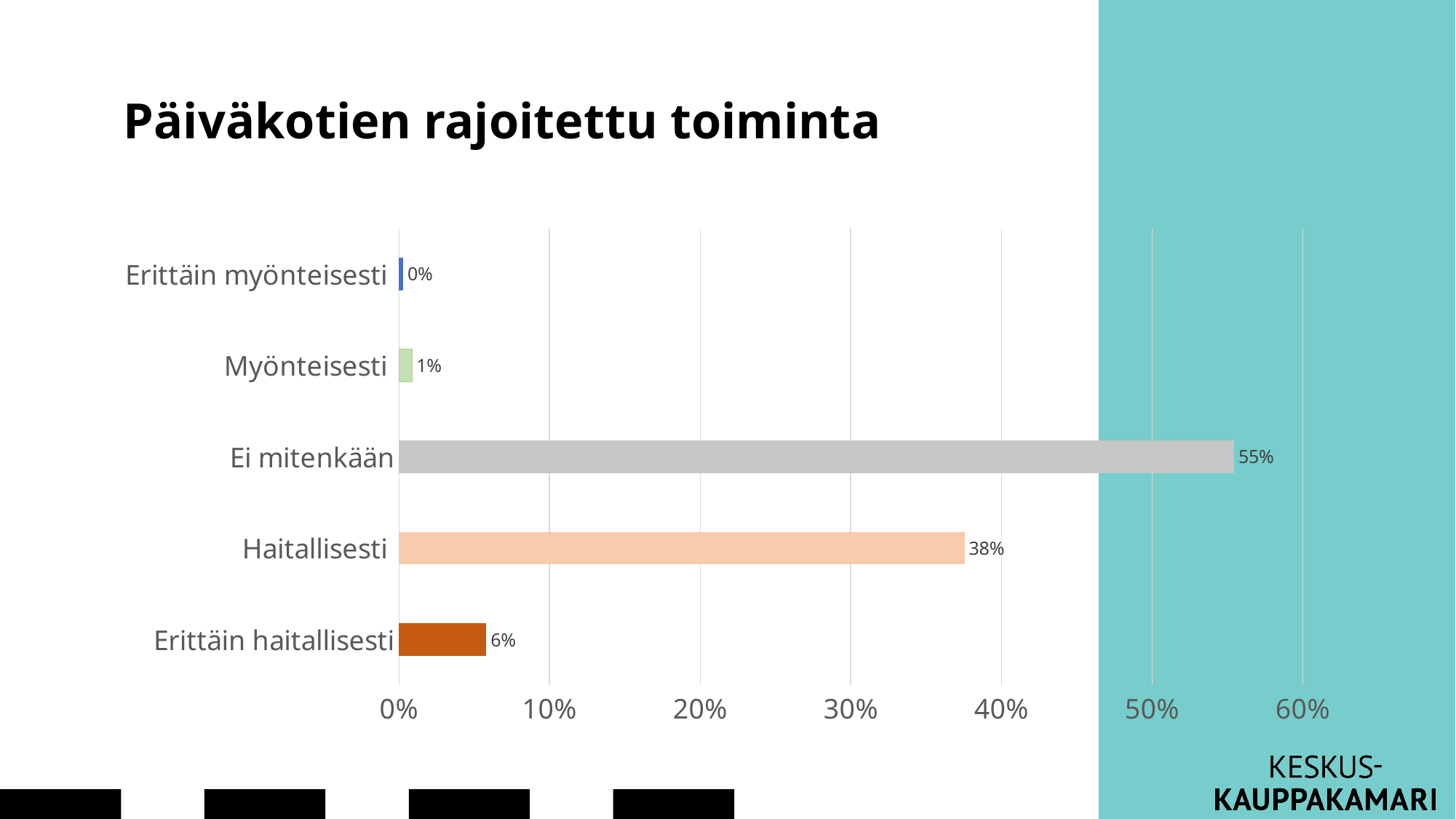
What is the value for Erittäin haitallisesti? 6% What kind of chart is shown on the slide? bar chart What is the value for Myönteisesti? 1% Is the value for Ei mitenkään greater or less than 50%? greater What is the value for Ei mitenkään? 55% Which is larger, the value for Haitallisesti or the value for Erittäin haitallisesti? Haitallisesti Which category has the lowest value? Erittäin myönteisesti Which category has the highest value? Ei mitenkään What is the difference between the values for Ei mitenkään and Haitallisesti? 17% How many categories are shown in the chart? 5 What is the value for Haitallisesti? 38% What is the title of the slide? Päiväkotien rajoitettu toiminta